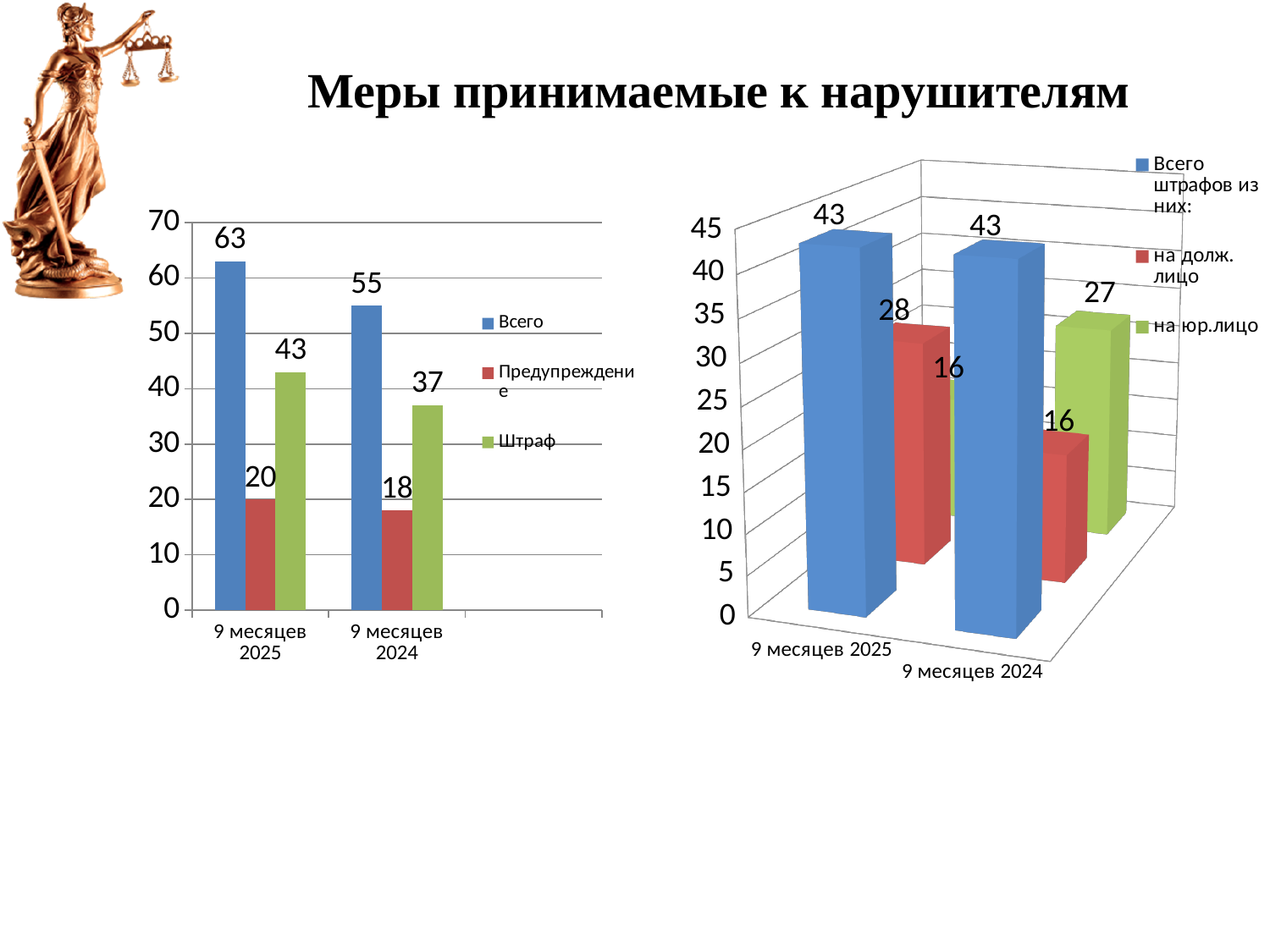
On the right chart, what is the value of на юр.лицо for 9 месяцев 2024? 27 On the right chart, which is larger: на долж. лицо for 9 месяцев 2025 or на долж. лицо for 9 месяцев 2024? 9 месяцев 2025 On the left chart, what kind of chart is it? Bar chart On the left chart, what is the difference between Всего for 9 месяцев 2025 and Всего for 9 месяцев 2024? 8 On the left chart, what is the value of Всего for 9 месяцев 2025? 63 On the left chart, what is the value of Штраф for 9 месяцев 2024? 37 On the left chart, how many series does the legend list? 3 On the right chart, what is the value of Всего штрафов for 9 месяцев 2024? 43 On the right chart, how many categories are shown on the x axis? 2 On the right chart, what is the value of на долж. лицо for 9 месяцев 2025? 28 On the left chart, which series has the lowest value for 9 месяцев 2024? Предупреждение On the left chart, what is the value of Предупреждение for 9 месяцев 2025? 20